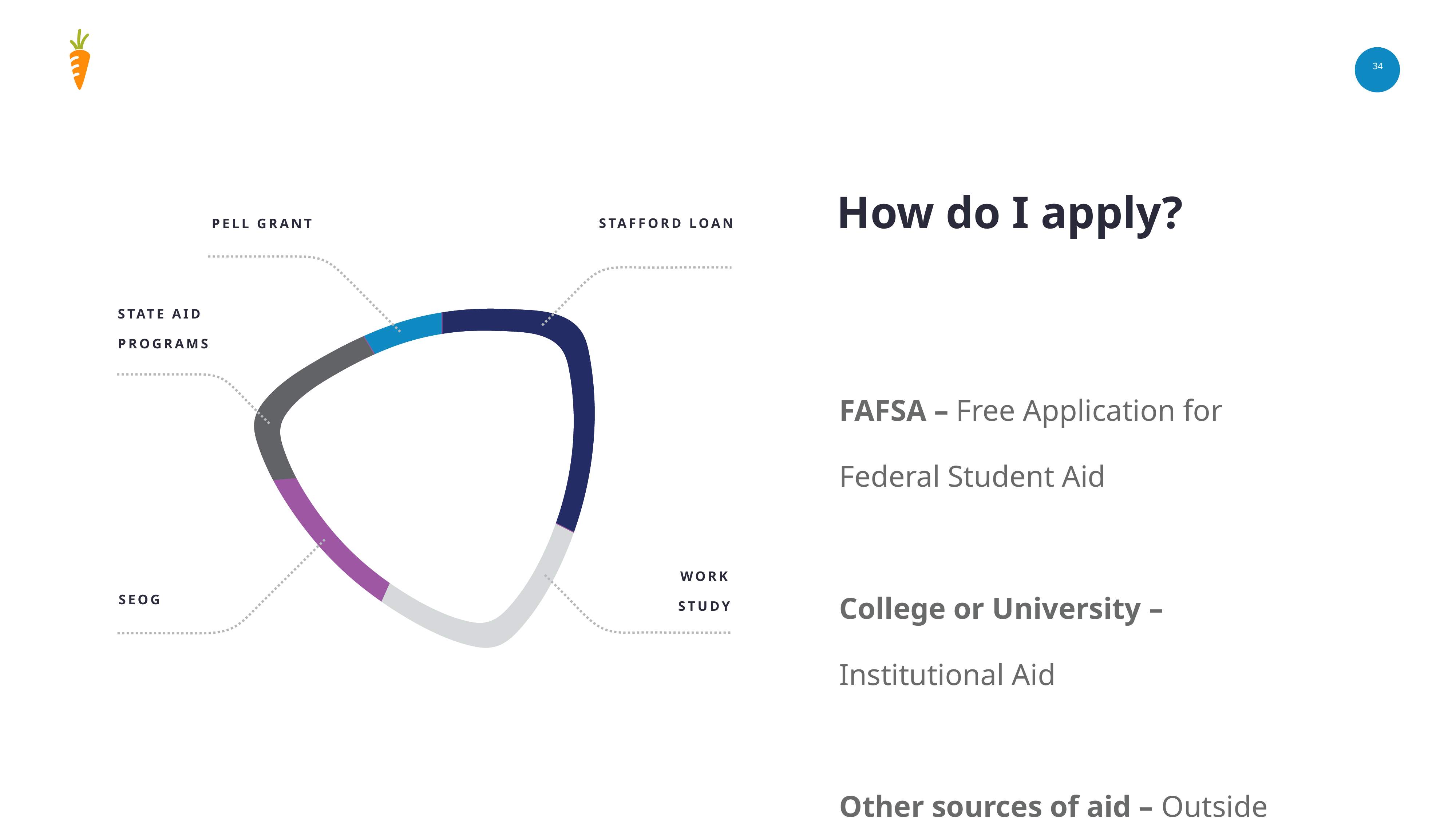
Which segment of the ring chart is the smallest? Pell Grant Which segment of the ring chart is coloured purple? SEOG In the ring chart, which segment is larger: Work Study or Pell Grant? Work Study Which segment of the ring chart is the largest? Stafford Loan In the ring chart, which segment is larger: Work Study or SEOG? Work Study How many segments does the ring chart on the left of the slide have? 5 In the ring chart, which segment is larger: Stafford Loan or SEOG? Stafford Loan What colour is the Pell Grant segment of the ring chart? Light blue